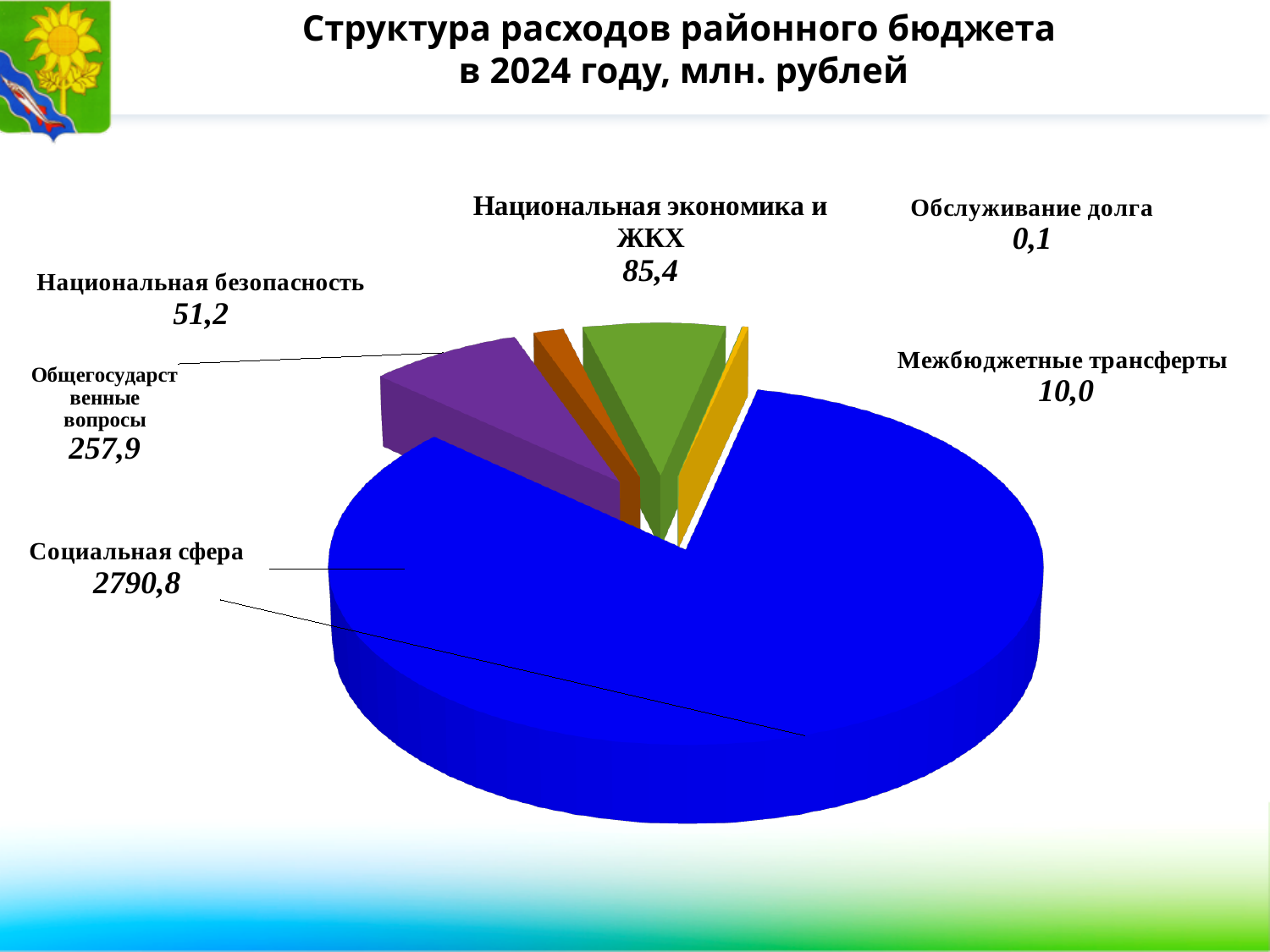
What is the value for Обслуживание долга? 0,1 What is the value for Социальная сфера? 2790,8 Which is larger, Межбюджетные трансферты or Национальная безопасность? Национальная безопасность What kind of chart is shown on the slide? Pie chart How many categories are shown in the pie chart? 6 What is the title of the chart? Структура расходов районного бюджета в 2024 году, млн. рублей Which category has the largest value? Социальная сфера What is the difference between Национальная экономика и ЖКХ and Национальная безопасность? 34,2 What is the value for Общегосударственные вопросы? 257,9 What is the value for Национальная экономика и ЖКХ? 85,4 What is the difference between Социальная сфера and Общегосударственные вопросы? 2532,9 Which category has the smallest value? Обслуживание долга